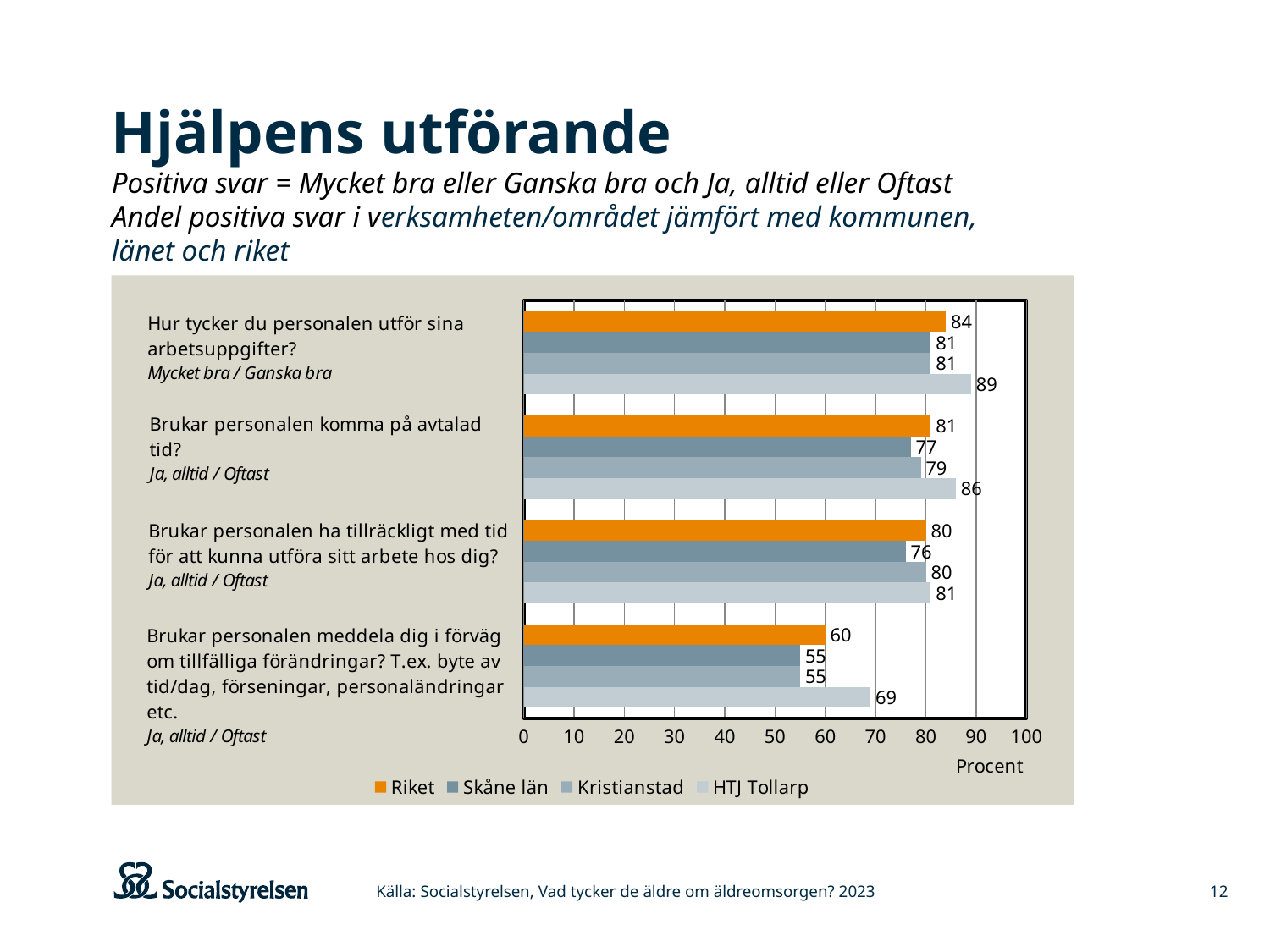
What is the label of the horizontal axis of the chart? Procent What is the value for Riket on the question "Brukar personalen komma på avtalad tid?"? 81 What is the value for Kristianstad on the question "Brukar personalen meddela dig i förväg om tillfälliga förändringar?"? 55 What is the value for HTJ Tollarp on the question "Hur tycker du personalen utför sina arbetsuppgifter?"? 89 Which is larger on the question "Hur tycker du personalen utför sina arbetsuppgifter?": the value for Riket or the value for HTJ Tollarp? HTJ Tollarp How many series does the legend list? 4 Which series has the highest value on the question "Brukar personalen komma på avtalad tid?"? HTJ Tollarp Which series has the lowest value on the question "Brukar personalen komma på avtalad tid?"? Skåne län How many questions (categories) are shown in the chart? 4 What kind of chart is shown on the slide? Bar chart What is the value for Skåne län on the question "Brukar personalen ha tillräckligt med tid för att kunna utföra sitt arbete hos dig?"? 76 What is the difference between HTJ Tollarp and Riket on the question "Brukar personalen meddela dig i förväg om tillfälliga förändringar?"? 9